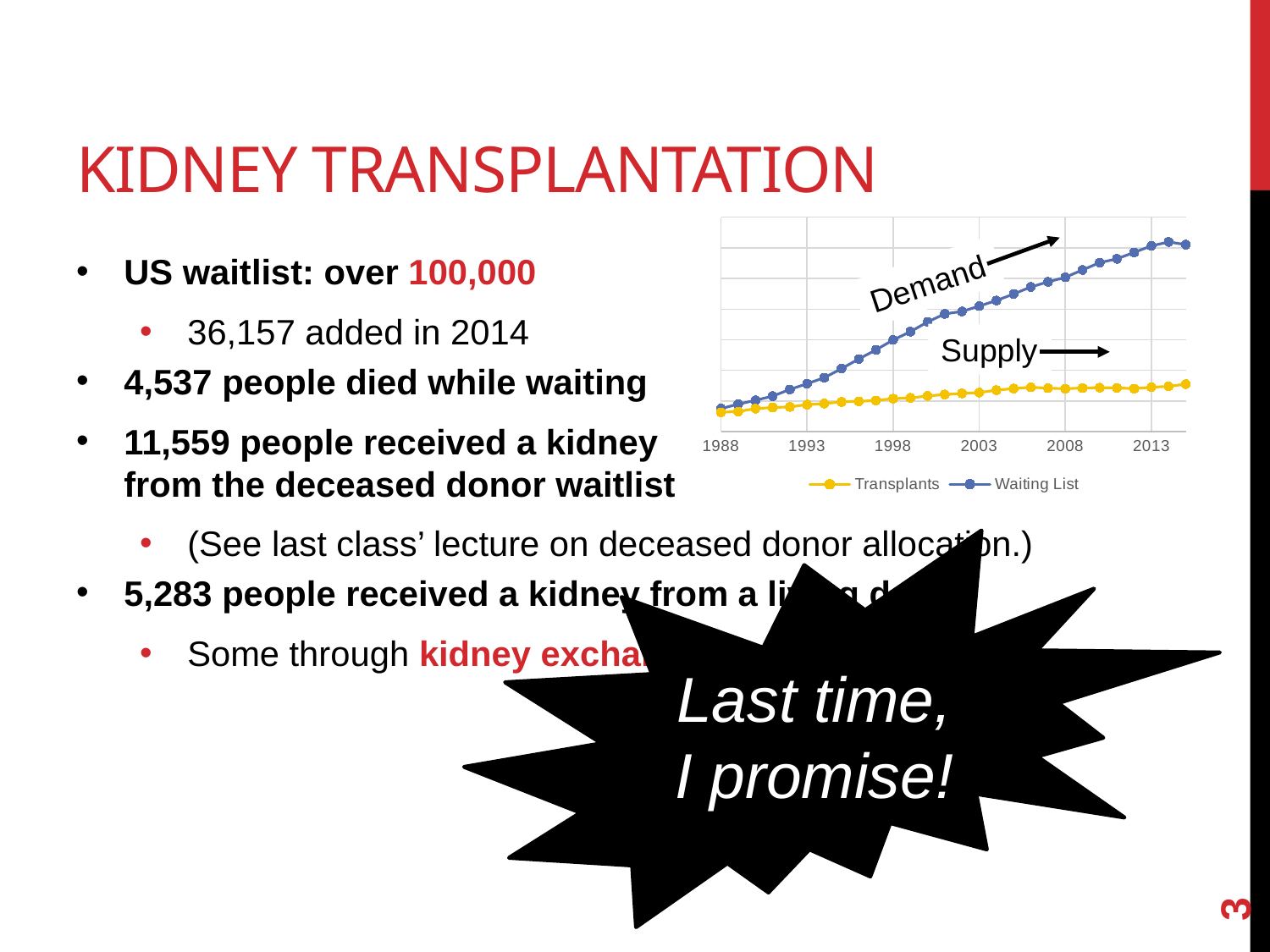
Which series grows faster over the period shown, Transplants or Waiting List? Waiting List Does the Transplants series rise or fall over the years shown? rise What kind of chart is shown on the slide? line chart Which series stays lowest across the chart? Transplants In 2013, which series has the higher value, Transplants or Waiting List? Waiting List Does the Waiting List series rise or fall from 1988 to 2013? rise What are the two series named in the chart's legend? Transplants and Waiting List What is the last year labeled on the chart's x axis? 2013 Which series is higher at the right end of the chart? Waiting List What is the first year labeled on the chart's x axis? 1988 Which series is annotated as "Demand" on the chart? Waiting List How many series does the chart's legend list? 2